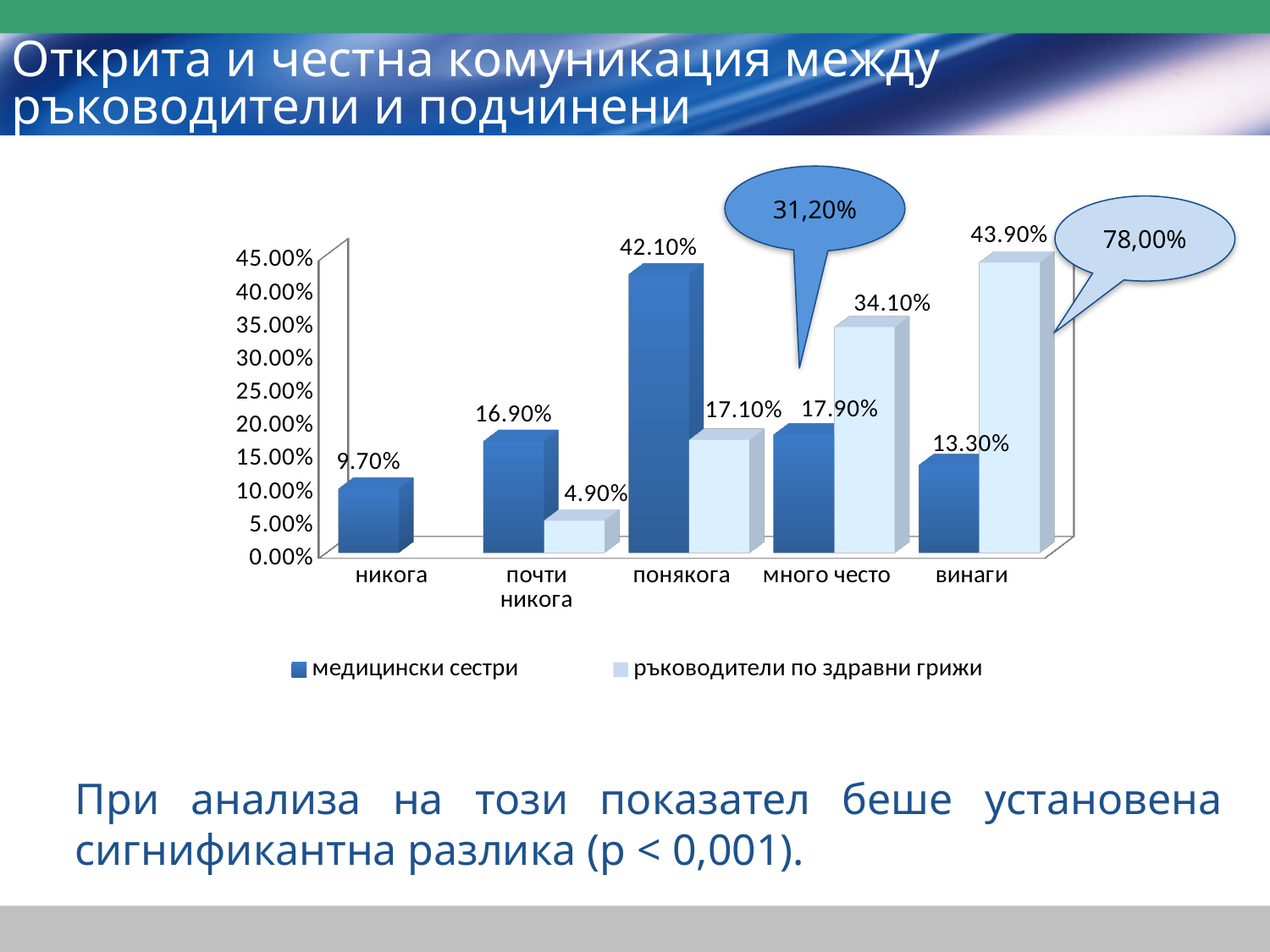
Which category has the highest value for медицински сестри? понякога What value is shown for ръководители по здравни грижи in the почти никога category? 4.90% What value is shown for ръководители по здравни грижи in the винаги category? 43.90% Which category has the lowest value for ръководители по здравни грижи among those with a labelled bar? почти никога How many categories are shown on the x axis? 5 In the много често category, which series has the larger value? ръководители по здравни грижи What value is shown in the callout pointing to the винаги bar for ръководители по здравни грижи? 78,00% What value is shown for медицински сестри in the никога category? 9.70% What is the difference between the two series in the винаги category? 30.60% What kind of chart is shown on the slide? bar chart How many series does the legend list? 2 What value is shown for медицински сестри in the понякога category? 42.10%